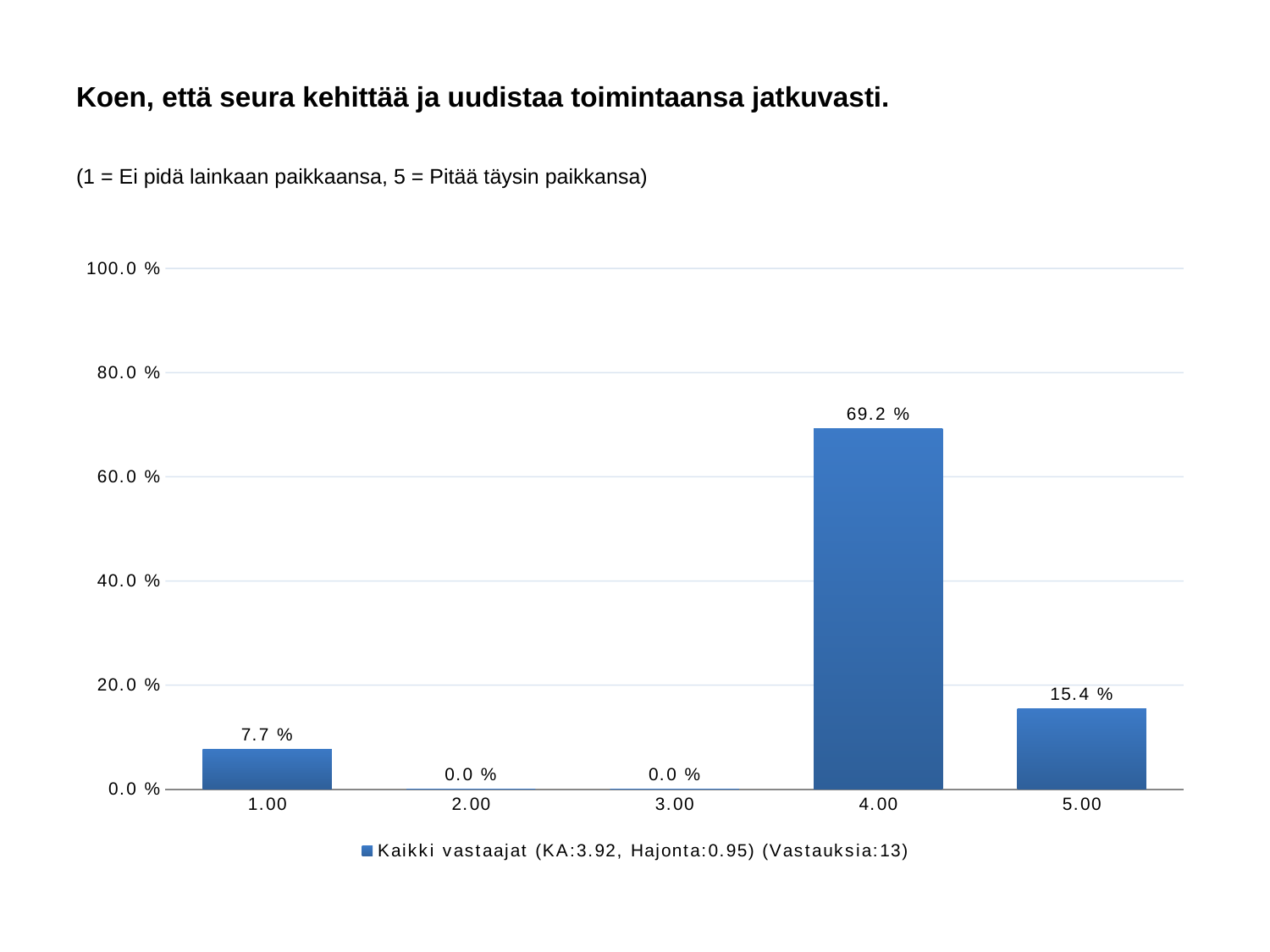
What kind of chart is shown on the slide? bar chart Which category has the highest value? 4.00 What is the value for category 4.00? 69.2 % Is the value for 4.00 greater or less than 60.0 %? greater What is the value for category 2.00? 0.0 % How many responses (Vastauksia) does the legend report? 13 What is the difference between the values for 4.00 and 5.00? 53.8 % What is the value for category 5.00? 15.4 % What is the value for category 1.00? 7.7 % What is the difference between the values for 5.00 and 1.00? 7.7 % Which is larger, the value for 1.00 or the value for 5.00? 5.00 How many categories are shown on the x axis? 5